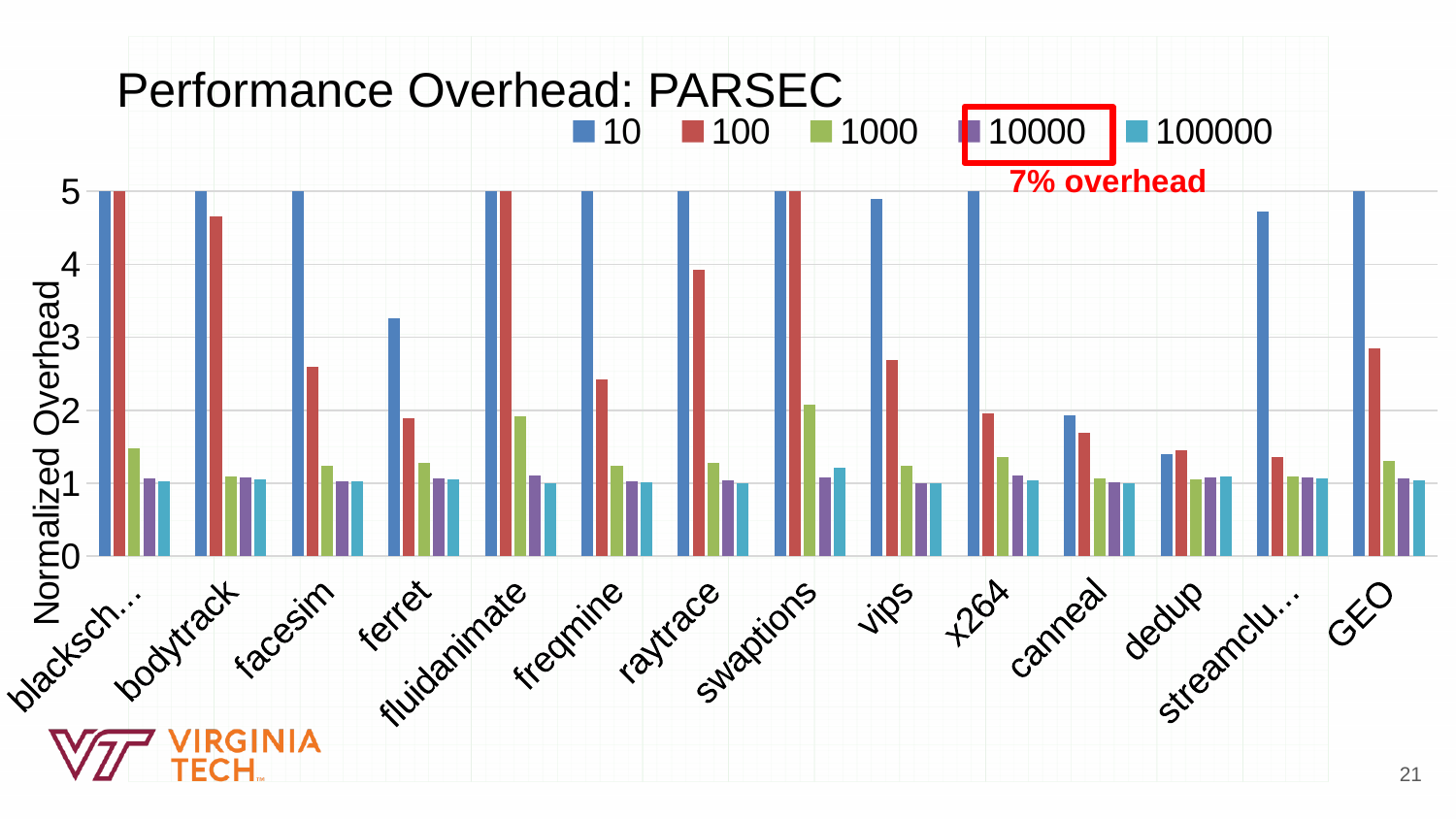
For the 10 series, which category has the lowest value? dedup Is the value of the 100 series for GEO greater or less than 3? less Is the value of the 100 series for vips greater or less than 2? greater How many series does the legend list? 5 How many benchmark categories are shown along the x axis? 14 What kind of chart is shown on the slide? bar chart Is the value of the 100 series for bodytrack greater or less than 4? greater For the 10 series, which is larger: ferret or bodytrack? bodytrack What is the title of the chart? Performance Overhead: PARSEC Which legend entry is highlighted with a red box and annotated as "7% overhead"? 10000